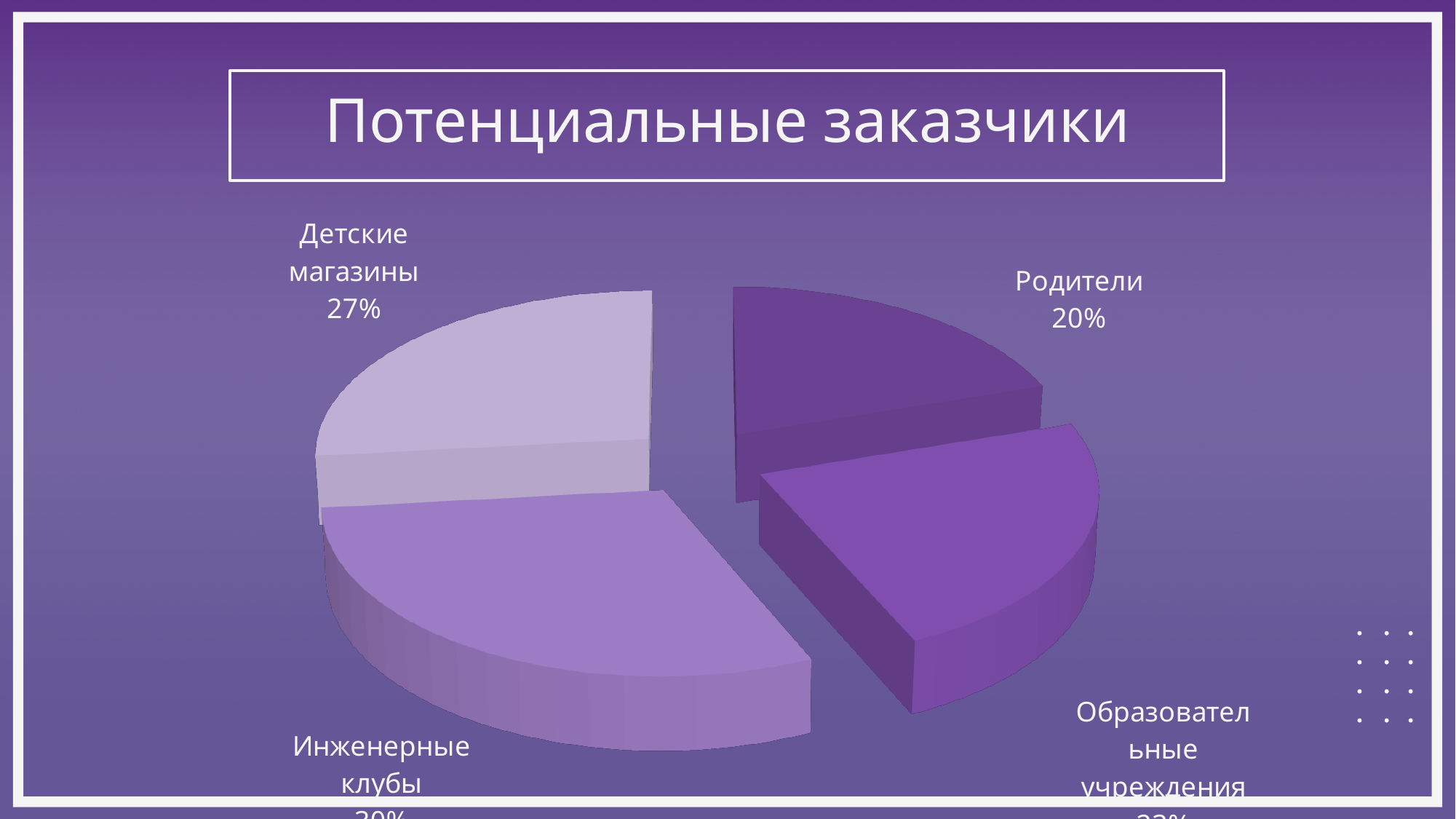
Which slice is labelled 20%? Родители What is the difference between the shares of Детские магазины and Родители? 7% Which is larger, the share for Детские магазины or the share for Родители? Детские магазины What is the value shown for Родители? 20% Which slice of the pie is the lightest in colour? Детские магазины What share of the pie does Родители have? 20% What kind of chart is shown on the slide? pie chart What is the title of the chart? Потенциальные заказчики What share of the pie does Детские магазины have? 27% How many slices does the pie chart have? 4 What is the value shown for Детские магазины? 27%